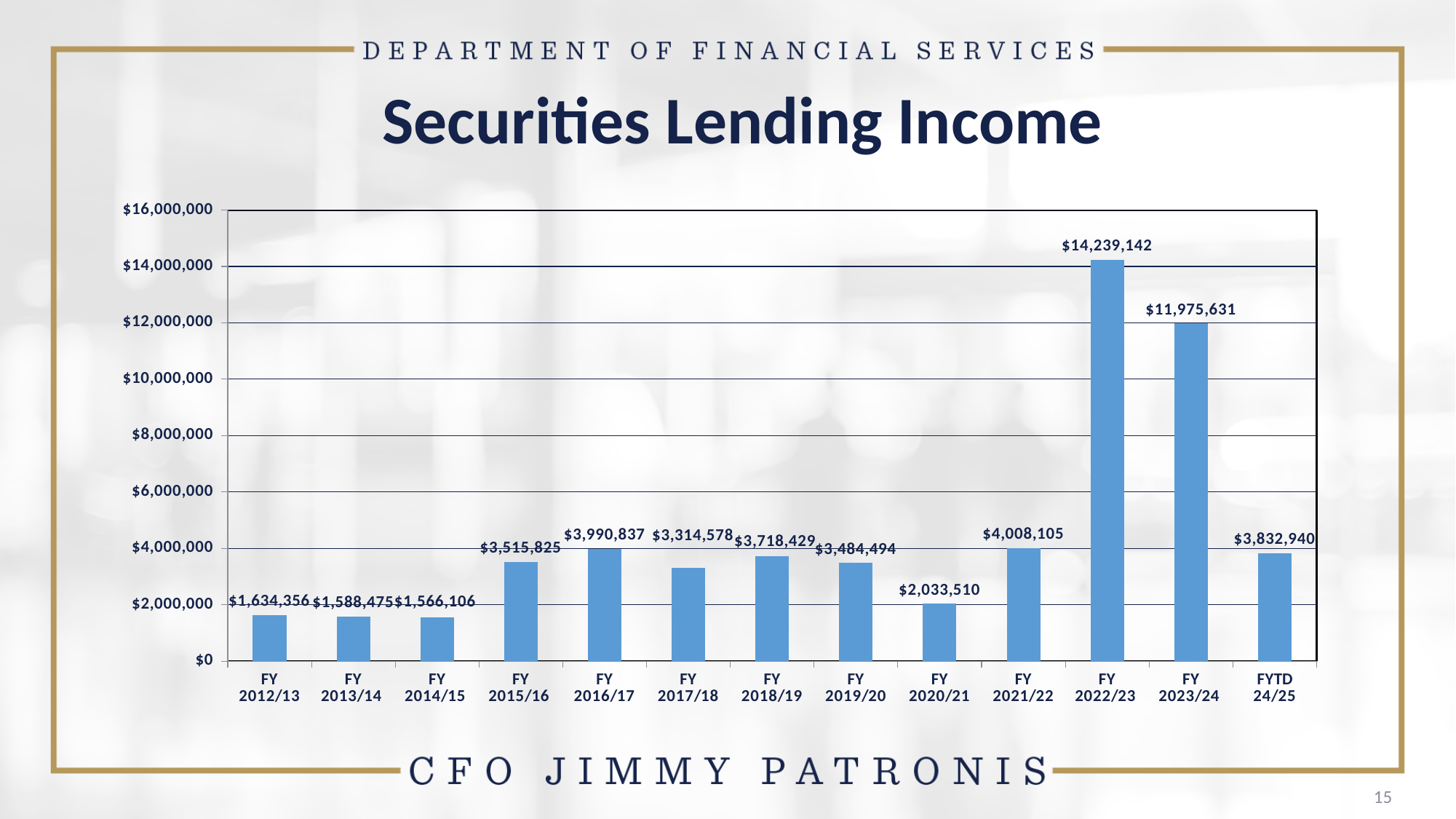
What is the securities lending income for FY 2016/17? $3,990,837 Which is larger, the securities lending income for FY 2018/19 or FY 2017/18? FY 2018/19 What type of chart is shown on the slide? Bar chart What is the difference between the securities lending income for FY 2022/23 and FY 2023/24? $2,263,511 Which fiscal year has the lowest securities lending income? FY 2014/15 What is the difference between the securities lending income for FY 2021/22 and FY 2020/21? $1,974,595 Is the securities lending income for FY 2023/24 greater or less than $10,000,000? greater What is the securities lending income for FYTD 24/25? $3,832,940 How many fiscal years are shown on the chart? 13 Which fiscal year has the highest securities lending income? FY 2022/23 What is the securities lending income for FY 2022/23? $14,239,142 What is the securities lending income for FY 2020/21? $2,033,510